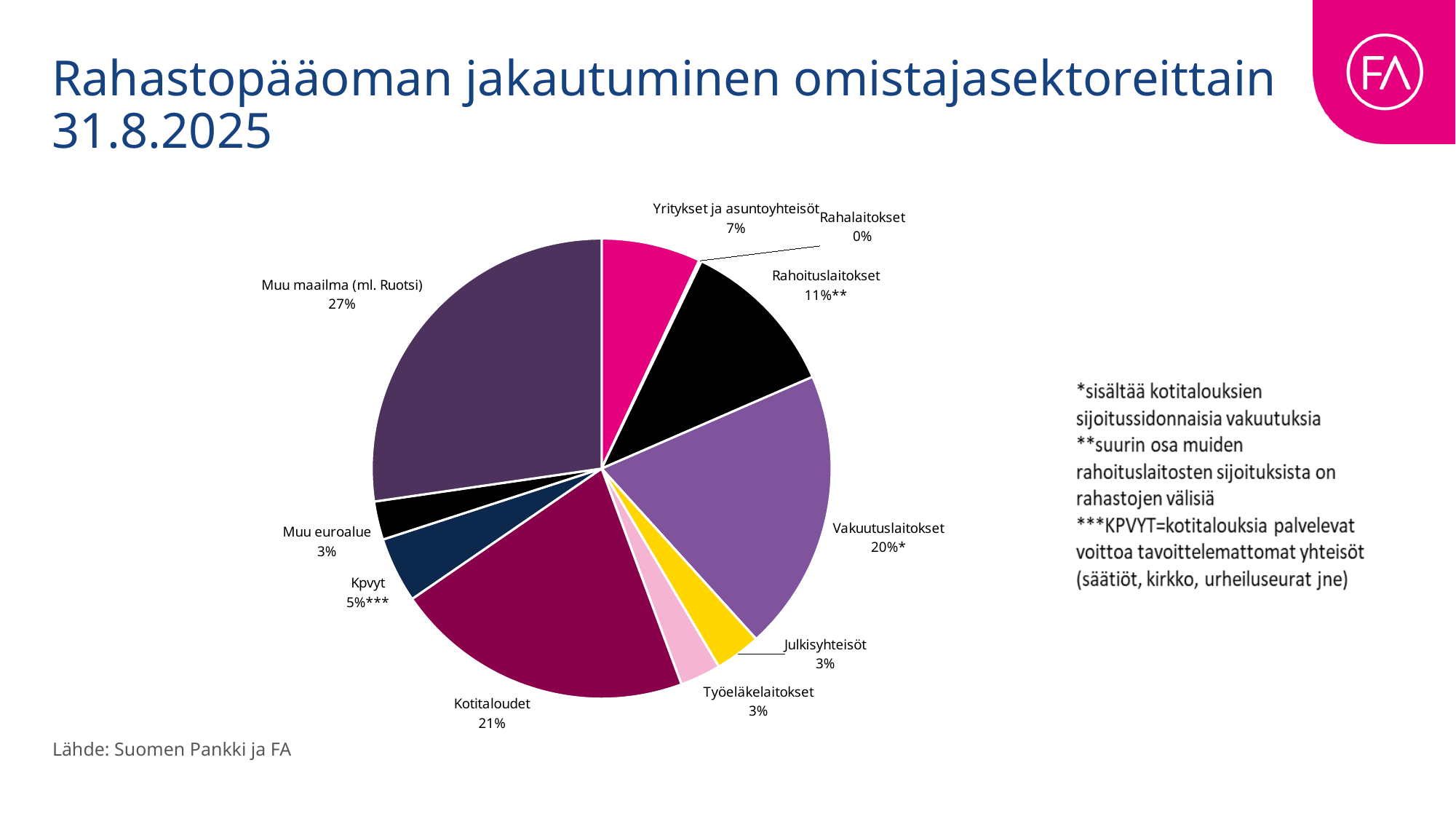
What is the value shown for Rahoituslaitokset? 11% Which sector has the largest share of the pie? Muu maailma (ml. Ruotsi) Which sector has the smallest share of the pie? Rahalaitokset How many sectors (slices) are labelled in the pie chart? 10 Which has the larger share, Kotitaloudet or Vakuutuslaitokset? Kotitaloudet What is the value shown for Vakuutuslaitokset? 20% How many percentage points larger is the share of Muu maailma (ml. Ruotsi) than that of Kotitaloudet? 6 What kind of chart is shown on the slide? pie chart What share of the pie does Muu maailma (ml. Ruotsi) hold? 27% What is the value shown for Kotitaloudet? 21% What is the value shown for Kpvyt? 5% What is the value shown for Yritykset ja asuntoyhteisöt? 7%